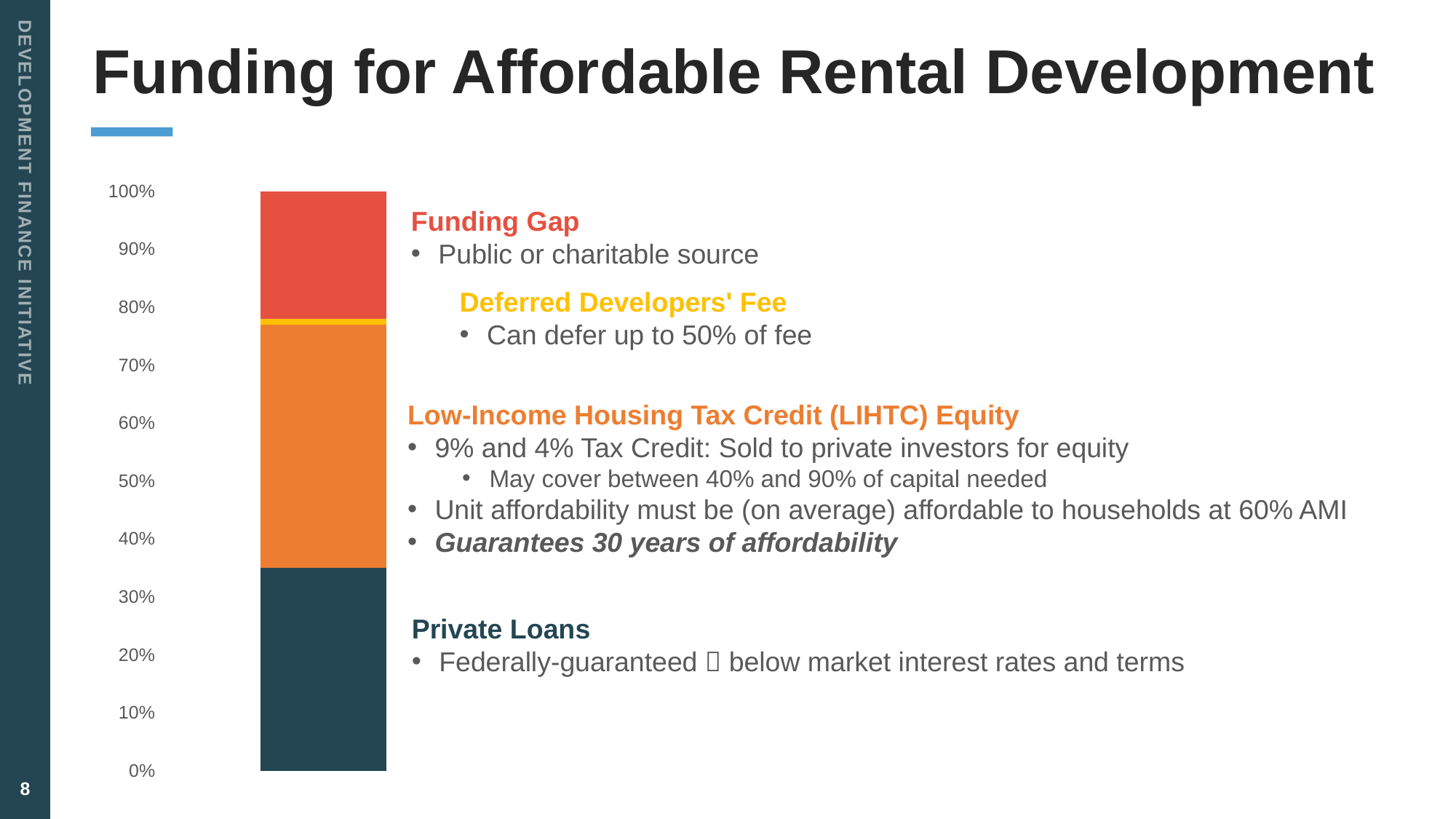
How many segments make up the stacked bar? 4 Is the top of the Private Loans segment greater or less than 40%? less Is the top of the LIHTC Equity segment greater or less than 70%? greater Which funding source occupies the smallest segment of the stacked bar? Deferred Developers' Fee Which funding source occupies the largest segment of the stacked bar? Low-Income Housing Tax Credit (LIHTC) Equity What kind of chart is shown on the slide? stacked bar chart What is the highest value shown on the vertical axis? 100% Is the top of the Private Loans segment greater or less than 30%? greater What colour is the segment representing the Funding Gap? red Which segment is larger: the LIHTC Equity segment or the Private Loans segment? LIHTC Equity How many bars does the chart contain? 1